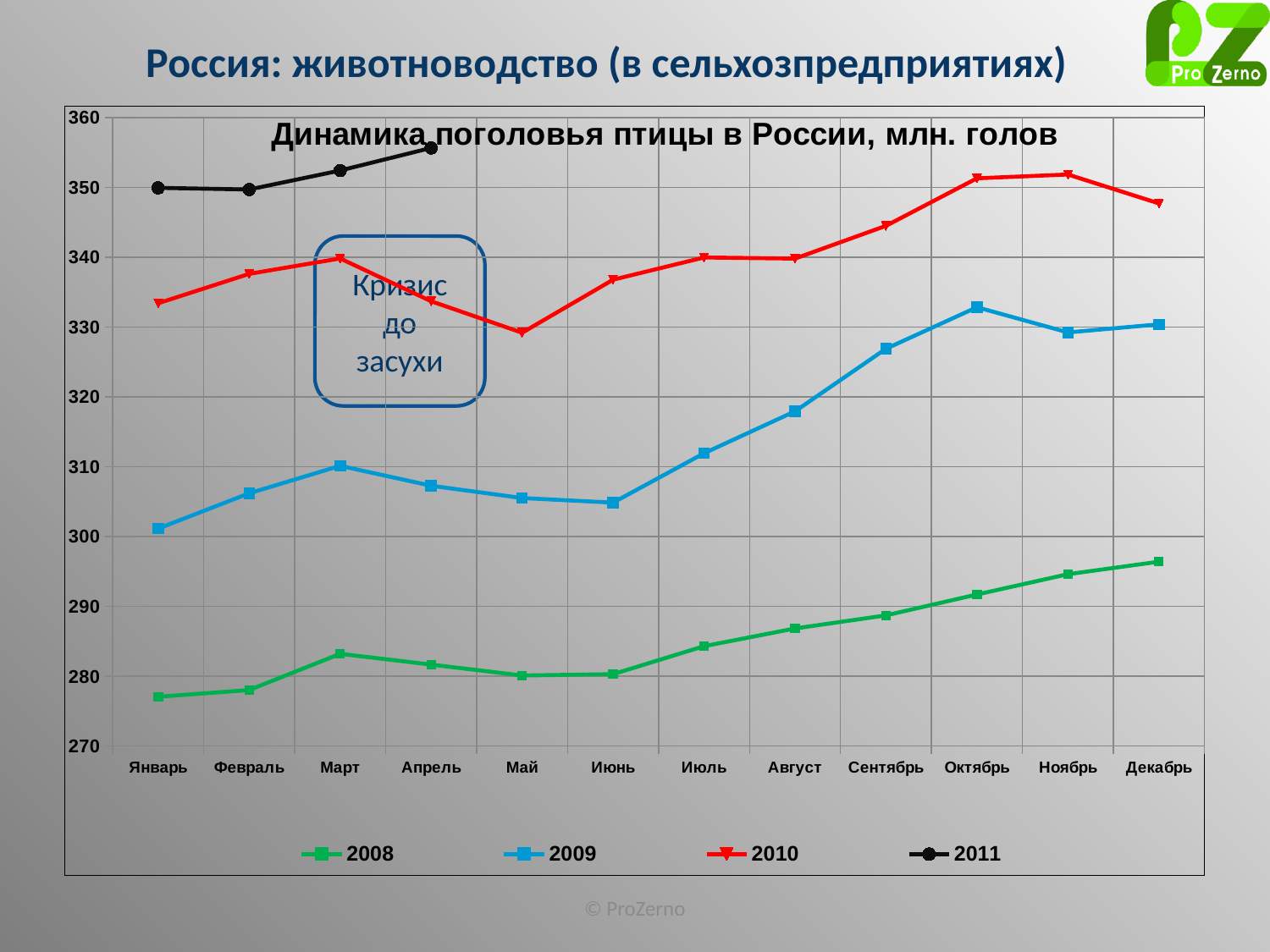
Is the value for 2011 in Апрель greater or less than 350? greater Is the value for 2008 in Декабрь greater or less than 300? less Is the value for 2009 in Октябрь greater or less than 330? greater Does the 2008 series rise or fall from Июнь to Декабрь? rise What is the title of the chart? Динамика поголовья птицы в России, млн. голов Which series has the larger value in Январь, 2009 or 2010? 2010 What kind of chart is shown on the slide? line chart In which month does the 2009 series reach its highest value? Октябрь How many months are shown along the x axis? 12 How many series does the legend list? 4 In which month does the 2010 series reach its lowest value? Май